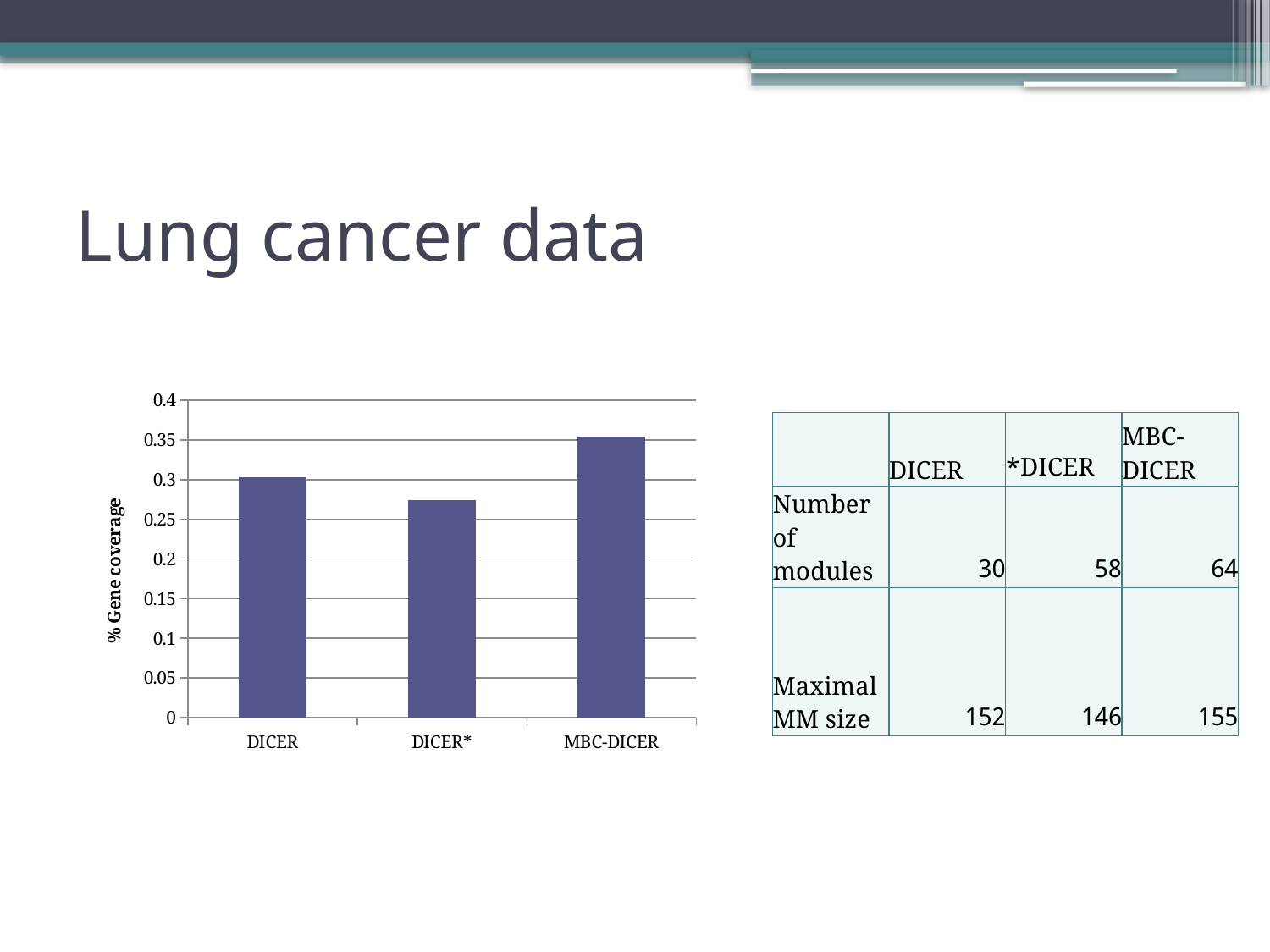
How many categories are plotted in the bar chart? 3 Which category has the lowest % Gene coverage in the bar chart? DICER* Is the value for MBC-DICER in the bar chart greater or less than 0.4? less What kind of chart is shown on the slide? bar chart In the bar chart, which has a higher % Gene coverage, DICER* or MBC-DICER? MBC-DICER Is the value for MBC-DICER in the bar chart greater or less than 0.3? greater Which category has the highest % Gene coverage in the bar chart? MBC-DICER Is the value for DICER* in the bar chart greater or less than 0.3? less In the bar chart, which has a higher % Gene coverage, DICER or DICER*? DICER What is the label of the vertical axis of the bar chart? % Gene coverage